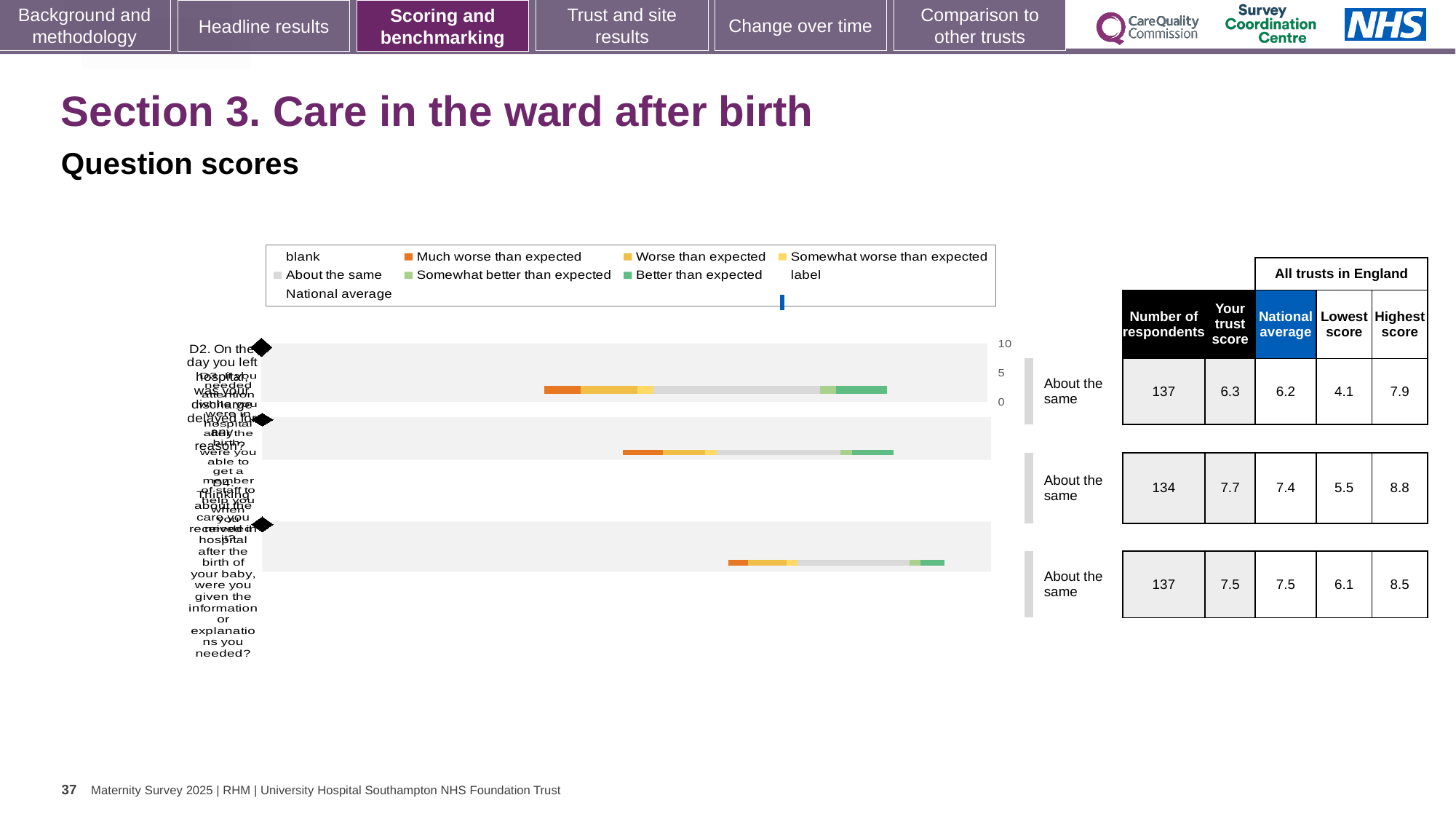
For the second (middle) row, is the 'Your trust score' or the 'National average' larger? Your trust score In the table beside the chart, what is the 'National average' for the second (middle) row? 7.4 What kind of chart is shown on the slide? bar chart For the second (middle) row, what is the difference between the 'Your trust score' and the 'National average'? 0.3 Which row in the table has the lowest 'Lowest score'? the first (top) row In the table beside the chart, what is the 'Highest score' for the third (bottom) row? 8.5 Which colour in the legend represents 'Much worse than expected'? orange In the table beside the chart, what is the 'Number of respondents' for the second (middle) row? 134 Which row in the table has the highest 'Your trust score'? the second (middle) row Which colour in the legend represents 'Better than expected'? green In the table beside the chart, what is the 'Your trust score' for the first (top) row? 6.3 How many stacked bars are plotted in the chart? 3